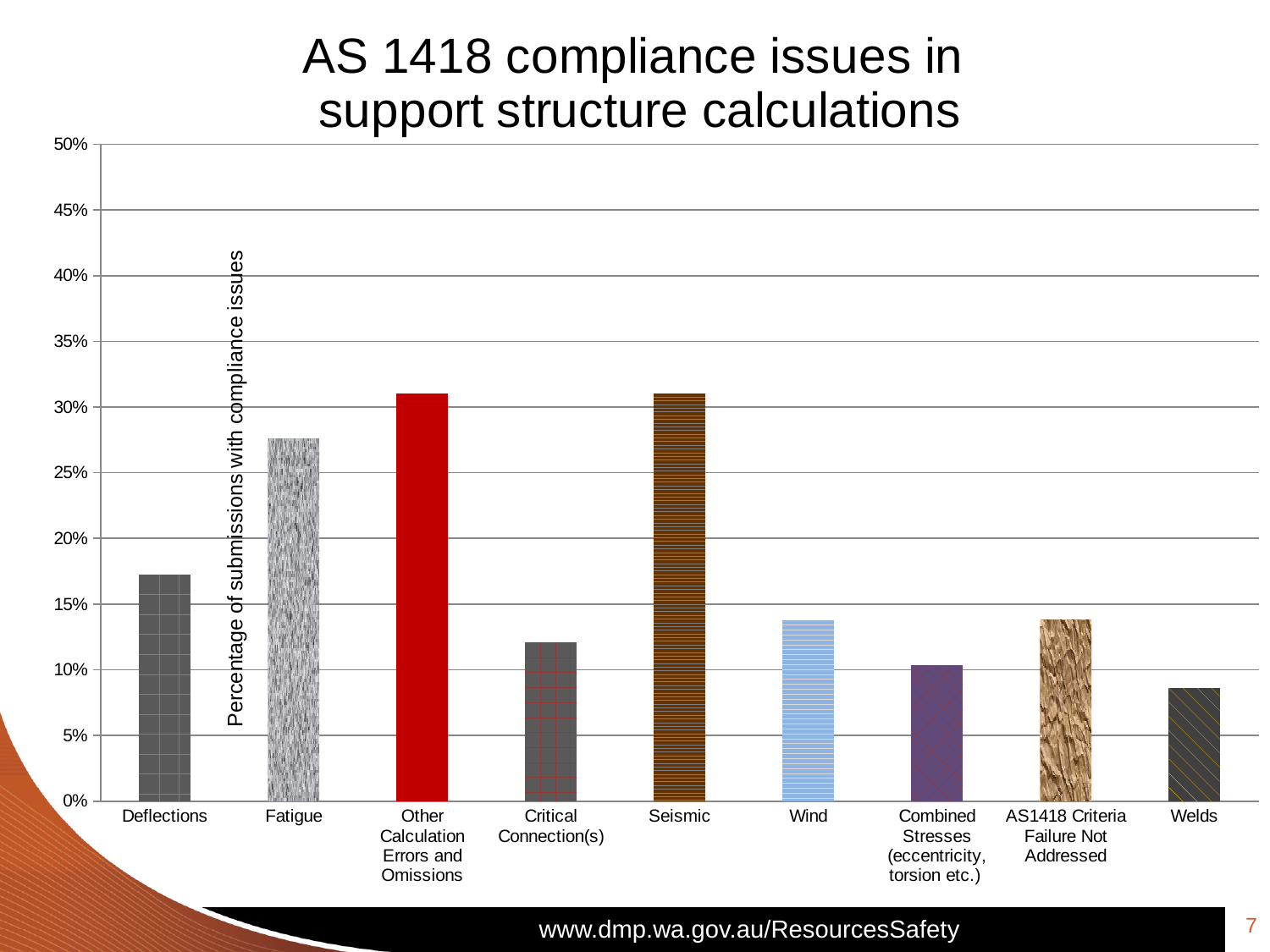
How many categories are plotted on the x axis of the chart? 9 Is the value for Welds greater or less than 10%? less Is the value for Critical Connection(s) greater or less than 15%? less What is the label on the vertical axis of the chart? Percentage of submissions with compliance issues Which category has the lowest percentage of submissions with compliance issues? Welds Which has a higher value, Wind or Welds? Wind Which has a higher value, Fatigue or Deflections? Fatigue What kind of chart is shown on the slide? bar chart What is the title of the chart? AS 1418 compliance issues in support structure calculations Is the value for Fatigue greater or less than 25%? greater